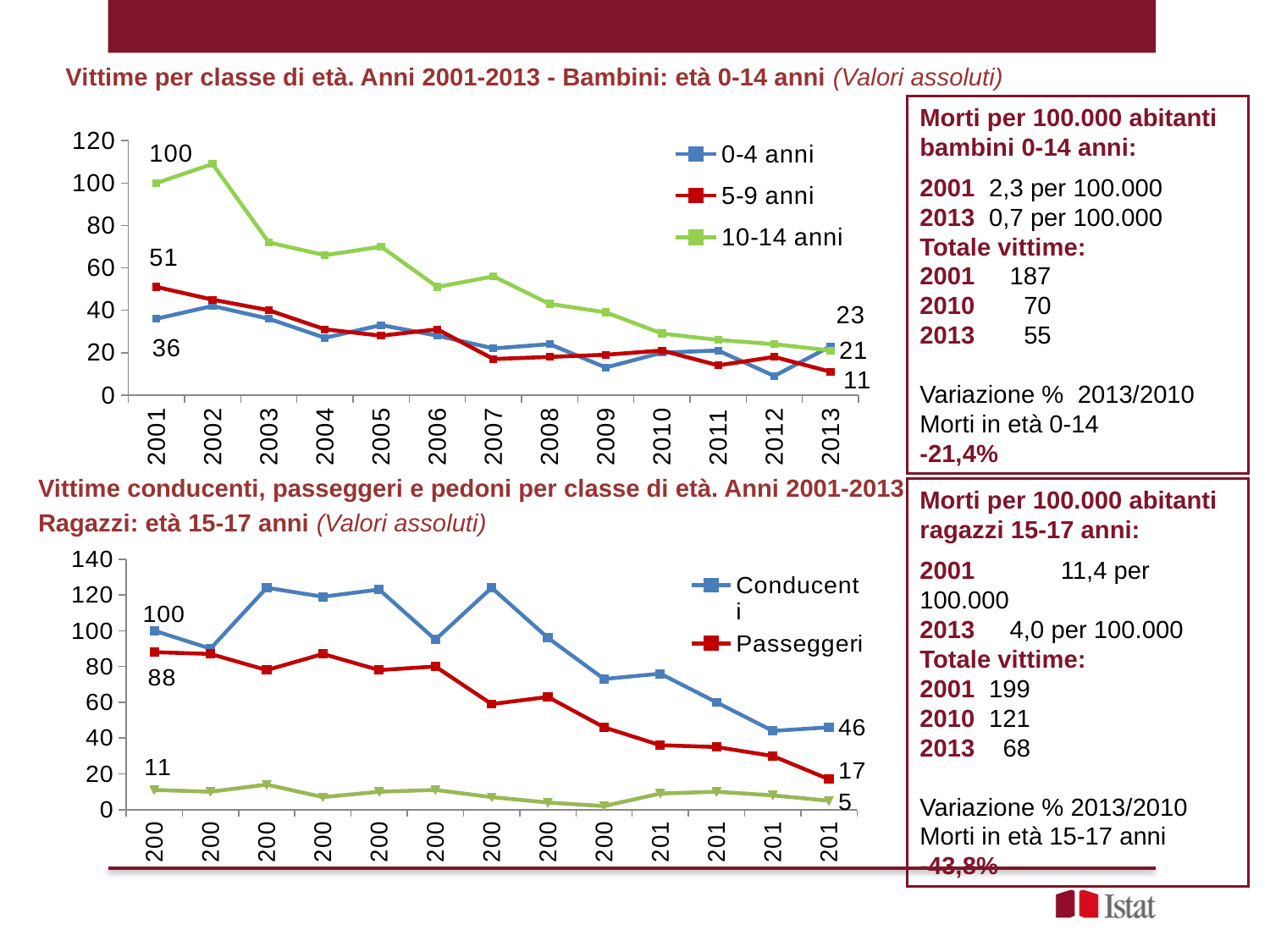
How many series does the legend of the top chart (Bambini 0-14 anni) list? 3 In the bottom chart (Ragazzi 15-17 anni), what is the difference between the Conducenti values in 2001 and 2013? 54 In the top chart (Bambini 0-14 anni), what is the difference between the 10-14 anni and 5-9 anni values in 2001? 49 In the top chart (Bambini 0-14 anni), does the 10-14 anni series rise or fall overall from 2001 to 2013? fall In the top chart (Bambini 0-14 anni), what is the value for 0-4 anni in 2001? 36 In the top chart (Bambini 0-14 anni), what is the value for 10-14 anni in 2001? 100 In the bottom chart (Ragazzi 15-17 anni), what is the value for Conducenti in 2013? 46 What kind of chart is the top chart, 'Vittime per classe di età... Bambini: età 0-14 anni'? line chart In the top chart (Bambini 0-14 anni), what is the value for 5-9 anni in 2013? 11 In the top chart (Bambini 0-14 anni), what is the value for 5-9 anni in 2001? 51 In the bottom chart (Ragazzi 15-17 anni), what is the value for Passeggeri in 2001? 88 In the bottom chart (Ragazzi 15-17 anni), is the value for Conducenti in 2003 greater or less than 100? greater